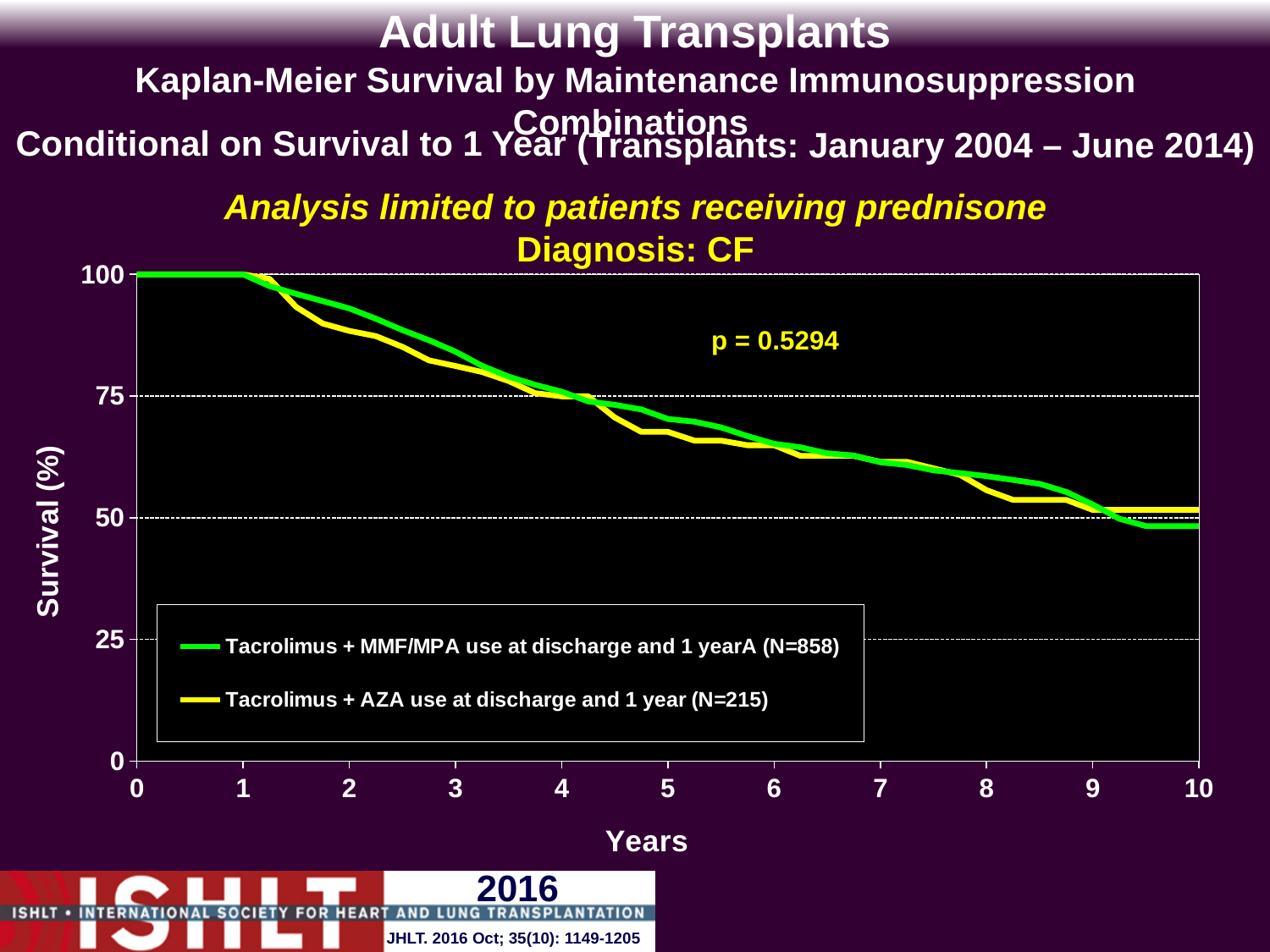
What is the N for the Tacrolimus + MMF/MPA series in the legend? N=858 Is the survival for Tacrolimus + AZA at year 5 greater or less than 75? less What p-value is printed on the chart? p = 0.5294 How many series does the legend list? 2 Do the survival curves rise or fall as years increase? fall What is the survival (%) for both series at year 0? 100 Is the survival for Tacrolimus + MMF/MPA at year 2 greater or less than 75? greater What kind of chart is shown on the slide? line chart Is the survival for Tacrolimus + MMF/MPA at year 8 greater or less than 50? greater How many tick marks are labelled on the x axis (Years)? 11 At year 10, which series has the higher survival, Tacrolimus + MMF/MPA or Tacrolimus + AZA? Tacrolimus + AZA At year 2, which series has the higher survival, Tacrolimus + MMF/MPA or Tacrolimus + AZA? Tacrolimus + MMF/MPA